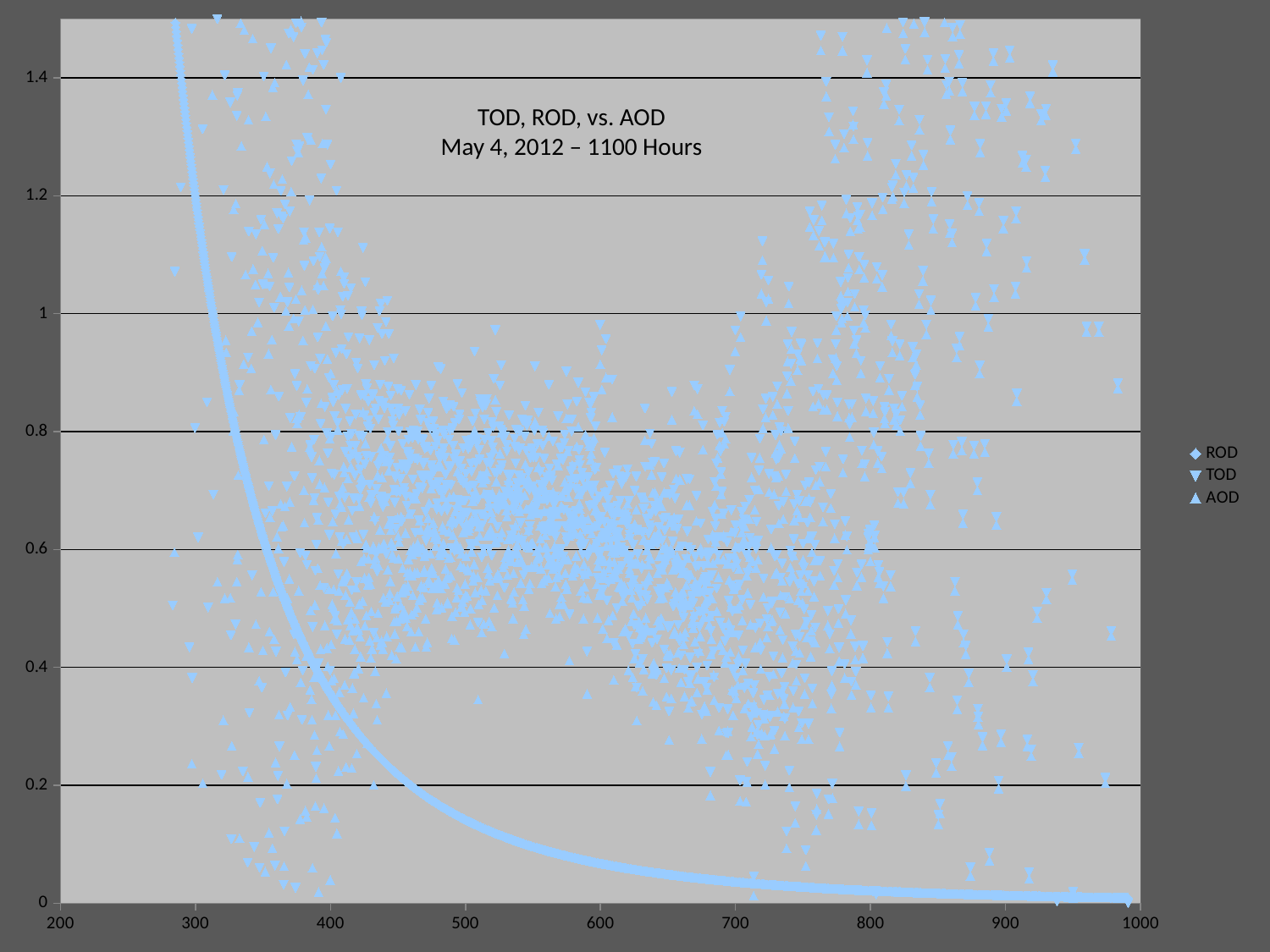
What is the highest value labelled on the x-axis? 1000 Which series are listed in the legend? ROD, TOD, AOD What is the title of the chart? TOD, ROD, vs. AOD May 4, 2012 – 1100 Hours Is the ROD value at x = 300 greater or less than 0.8? greater Is the ROD value at x = 800 greater or less than 0.2? less Does the ROD series rise or fall as the x-axis value increases? fall How many series does the legend list? 3 Is the ROD value at x = 500 greater or less than 0.2? less What kind of chart is shown on the slide? scatter chart